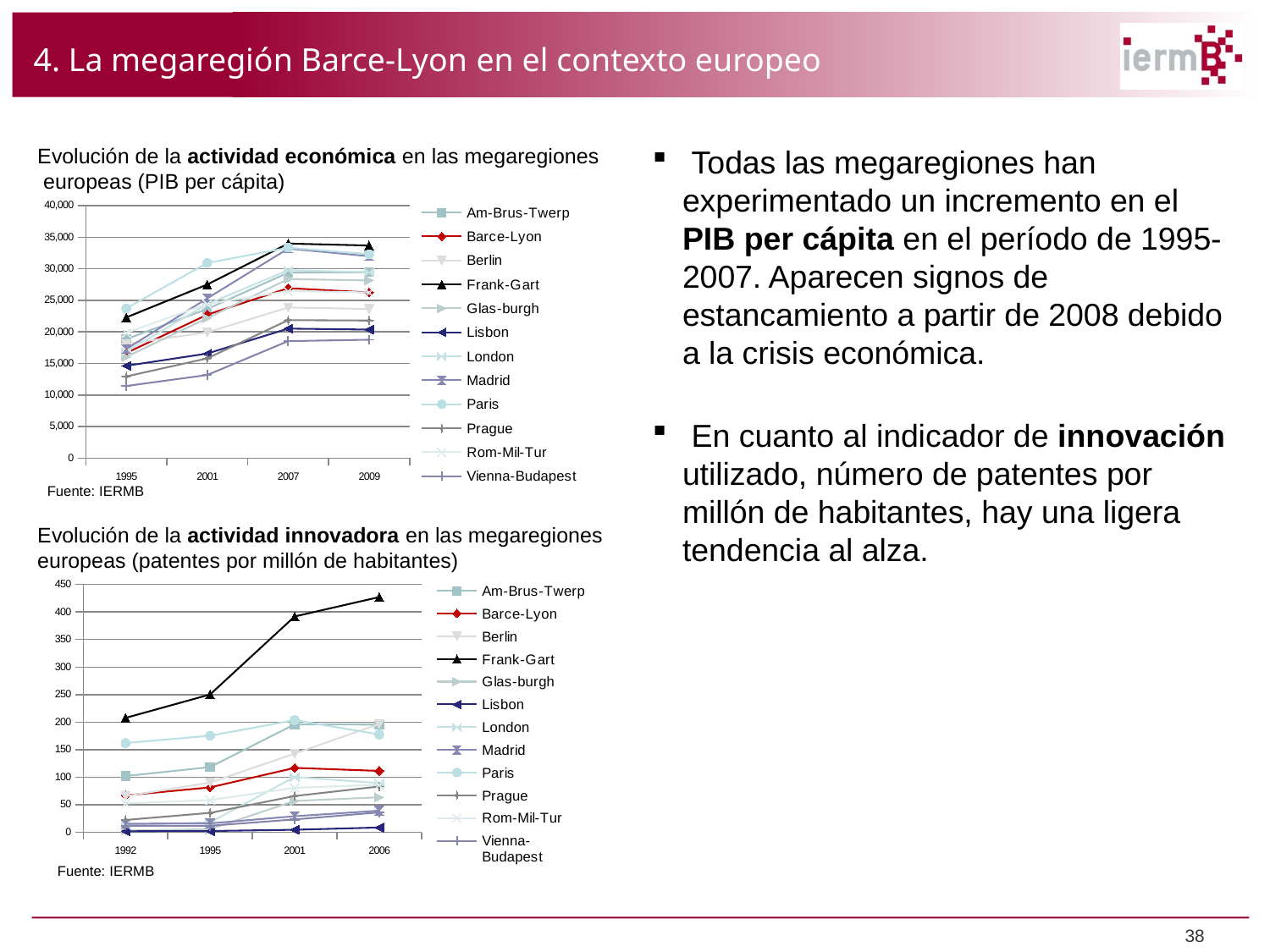
In the top chart (PIB per cápita), which is larger in 2009, Frank-Gart or Barce-Lyon? Frank-Gart In the top chart (PIB per cápita), is the value for Frank-Gart in 1995 greater or less than 20,000? greater In the top chart (PIB per cápita), is the value for Vienna-Budapest in 1995 greater or less than 15,000? less In the top chart (PIB per cápita), which megaregion has the highest value in 2009? Frank-Gart In the bottom chart (patentes por millón de habitantes), does the Frank-Gart line rise or fall from 1992 to 2006? rise In the top chart (PIB per cápita), which megaregion has the lowest value in 1995? Vienna-Budapest In the bottom chart (patentes por millón de habitantes), which megaregion has the highest value in 2006? Frank-Gart In the bottom chart (patentes por millón de habitantes), is the value for Frank-Gart in 2006 greater or less than 400? greater How many series does the legend of the bottom chart (patentes por millón de habitantes) list? 12 How many years are shown on the x axis of the top chart (PIB per cápita)? 4 In the bottom chart (patentes por millón de habitantes), which is larger in 1992, Frank-Gart or Paris? Frank-Gart What kind of chart is the top chart on the slide (PIB per cápita)? line chart